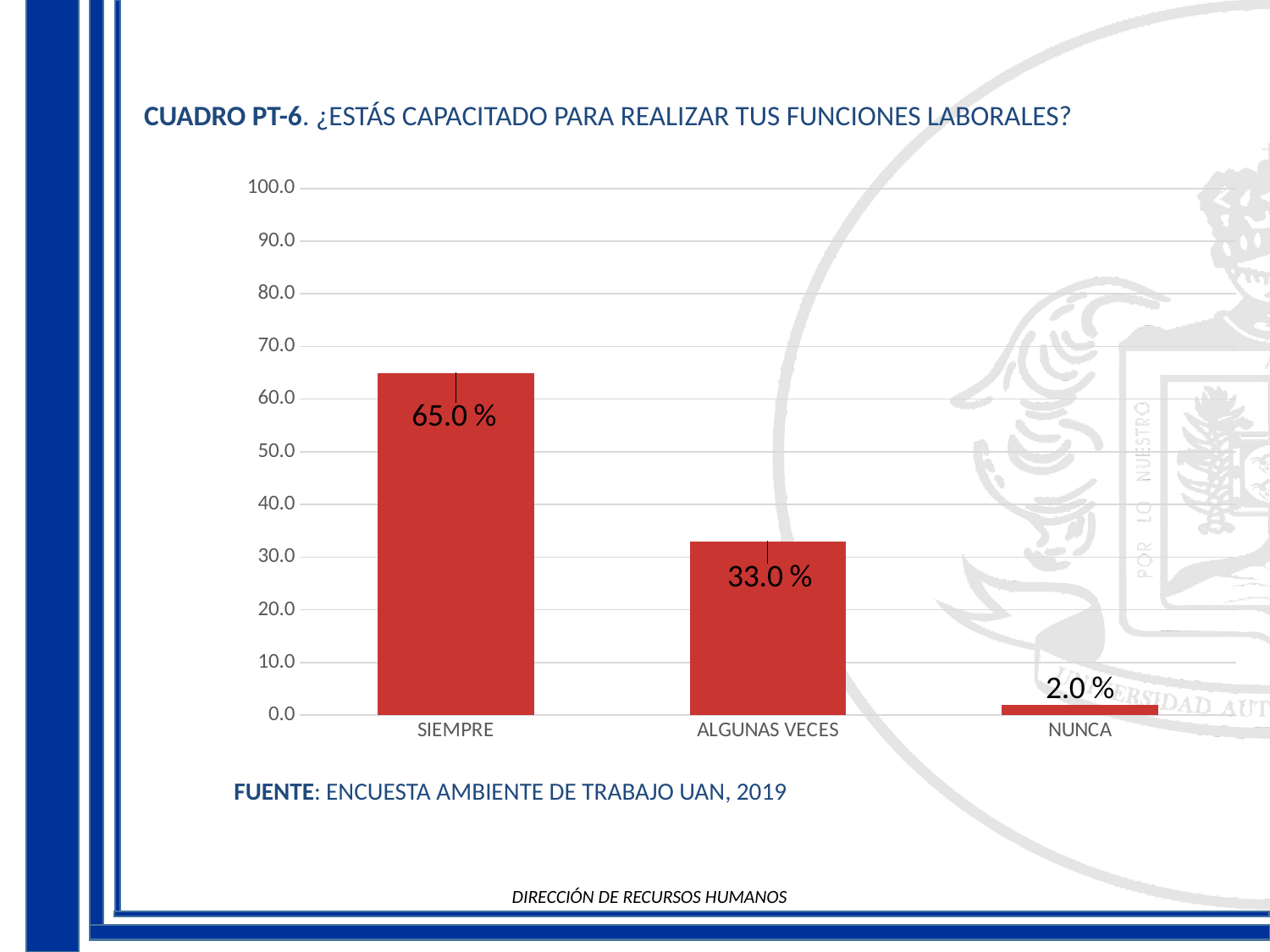
Which is larger, the value for ALGUNAS VECES or the value for NUNCA? ALGUNAS VECES What is the difference between the values for ALGUNAS VECES and NUNCA? 31.0 % What is the source cited below the chart? ENCUESTA AMBIENTE DE TRABAJO UAN, 2019 What is the value for SIEMPRE? 65.0 % What kind of chart is shown on the slide? bar chart What is the value for ALGUNAS VECES? 33.0 % What is the value for NUNCA? 2.0 % What is the difference between the values for SIEMPRE and ALGUNAS VECES? 32.0 % Which category has the lowest value? NUNCA How many categories are shown on the x axis? 3 Which category has the highest value? SIEMPRE Is the value for SIEMPRE greater or less than 60.0? greater